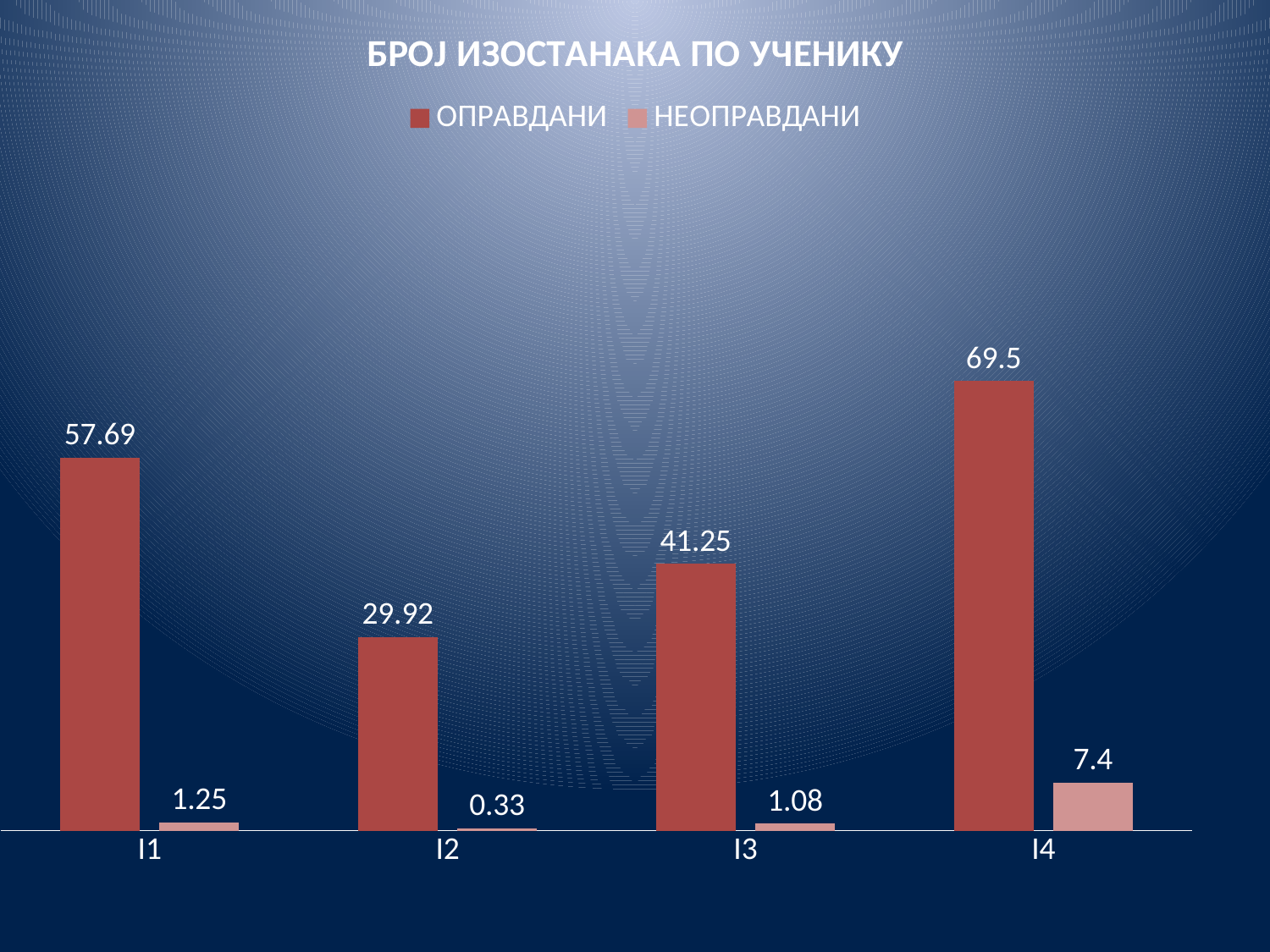
What is the НЕОПРАВДАНИ value for I4? 7.4 Which category has the lowest ОПРАВДАНИ value? I2 Which category has the highest ОПРАВДАНИ value? I4 What is the ОПРАВДАНИ value for I3? 41.25 Which category has the lowest НЕОПРАВДАНИ value? I2 What is the ОПРАВДАНИ value for I1? 57.69 Which is larger, the ОПРАВДАНИ value for I3 or for I2? I3 How many categories are shown on the x axis? 4 How many series does the legend list? 2 What kind of chart is shown on the slide? Bar chart What is the difference between the ОПРАВДАНИ values for I4 and I1? 11.81 What is the НЕОПРАВДАНИ value for I2? 0.33